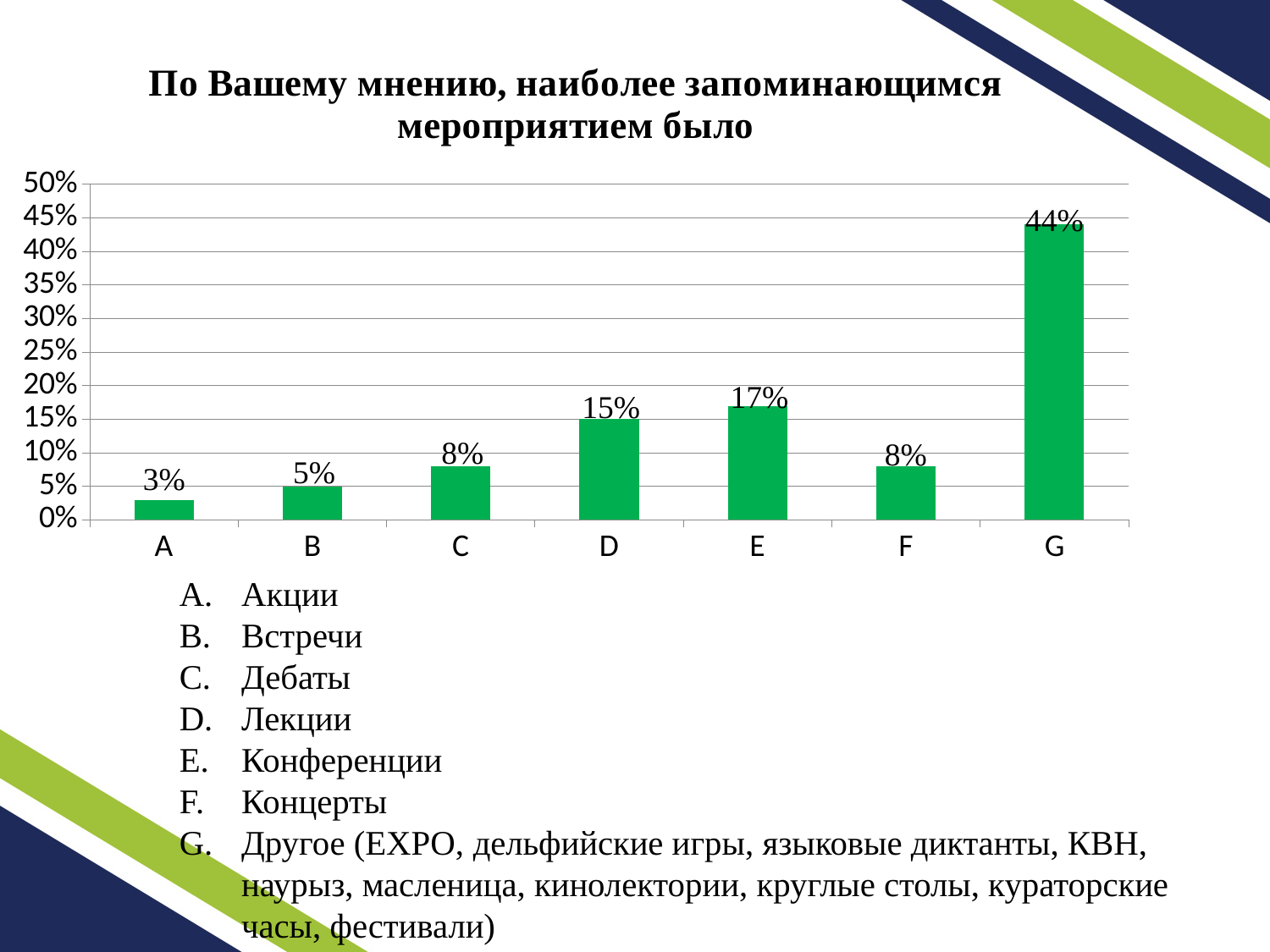
Is the value for G greater or less than 40%? greater What is the value for category A? 3% Which category has the lowest value? A Which category has the highest value? G How many categories are shown on the x axis? 7 What kind of chart is shown on the slide? bar chart Which two categories share the same value of 8%? C and F What is the value for category G? 44% What is the value for category D? 15% What is the difference between the values for G and E? 27% What is the difference between the values for D and B? 10% Which is larger, the value for E or the value for D? E